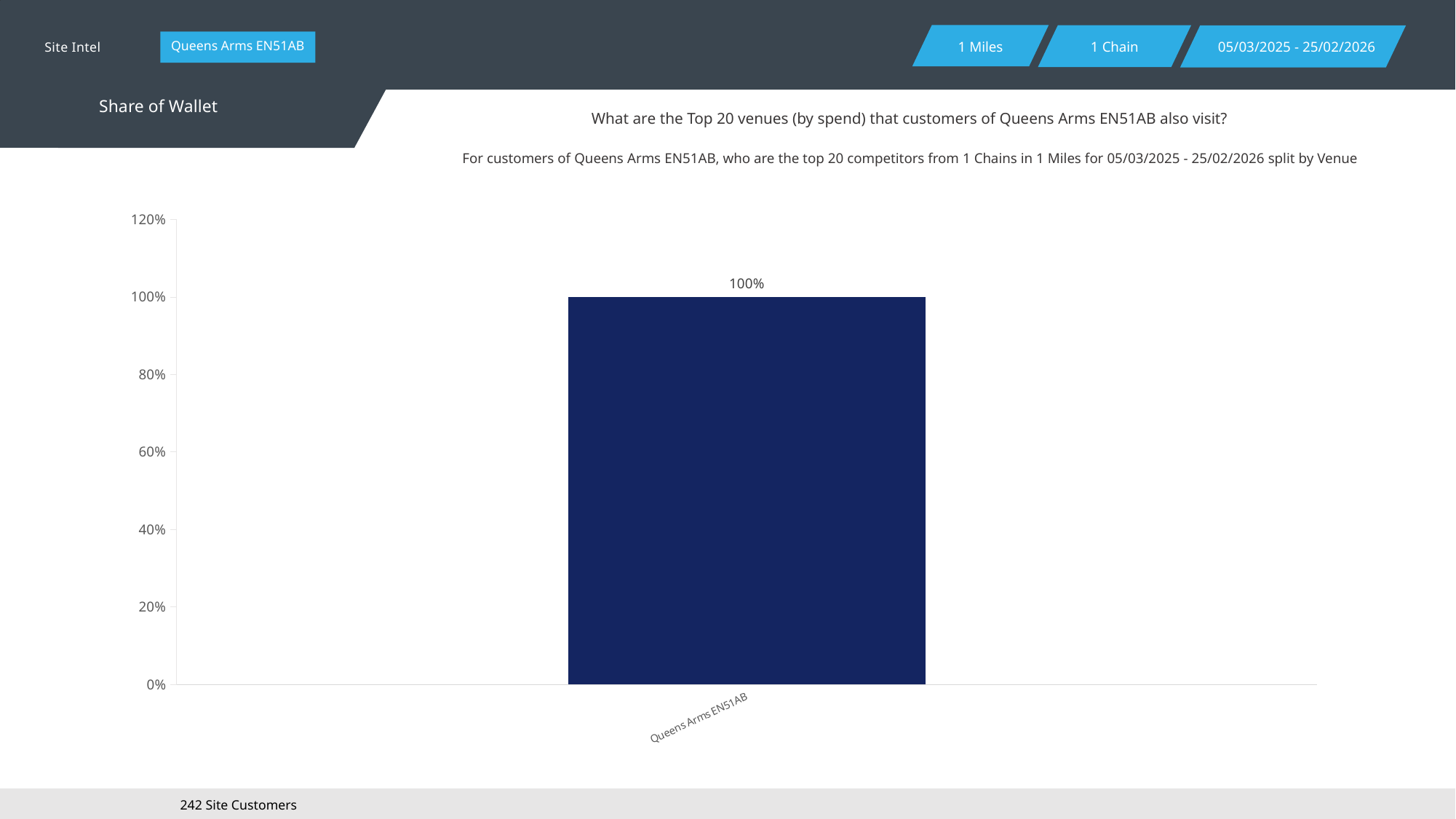
What is the highest value shown on the y axis? 120% How many bars are plotted on the chart? 1 What is the value shown for Queens Arms EN51AB? 100% Which category has the highest value on the chart? Queens Arms EN51AB Which venue is shown on the x axis of the chart? Queens Arms EN51AB Is the value for Queens Arms EN51AB greater or less than 80%? greater Is the value for Queens Arms EN51AB greater or less than 120%? less What kind of chart is shown on the slide? bar chart